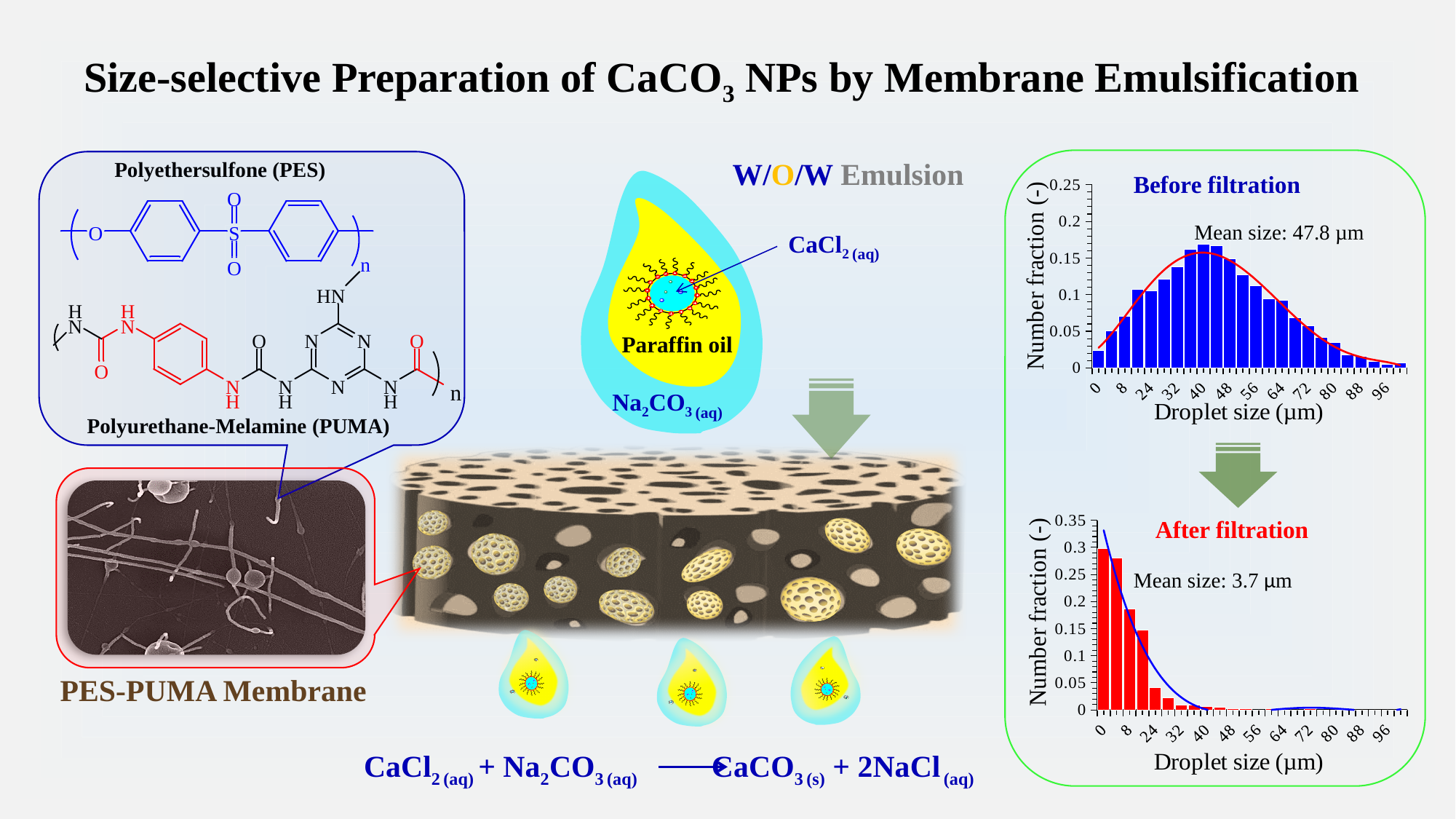
In the "After filtration" chart, is the number fraction of the first bar at droplet size 0 greater or less than 0.25? greater What is the x-axis title of the "After filtration" chart? Droplet size (µm) In the "Before filtration" chart, what mean droplet size is stated? 47.8 µm What colour are the bars in the "After filtration" chart? red Which chart has the taller peak bar, "Before filtration" or "After filtration"? After filtration In the "Before filtration" chart, is the number fraction of the tallest bar greater or less than 0.15? greater In the "After filtration" chart, do the number fractions rise or fall as droplet size increases from 0 to 40 µm? fall In the "Before filtration" chart, is the number fraction for the first bar at droplet size 0 greater or less than 0.05? less In the "After filtration" chart, what mean droplet size is stated? 3.7 µm Which chart reports the larger mean droplet size, "Before filtration" or "After filtration"? Before filtration What kind of chart is the "Before filtration" chart? bar chart